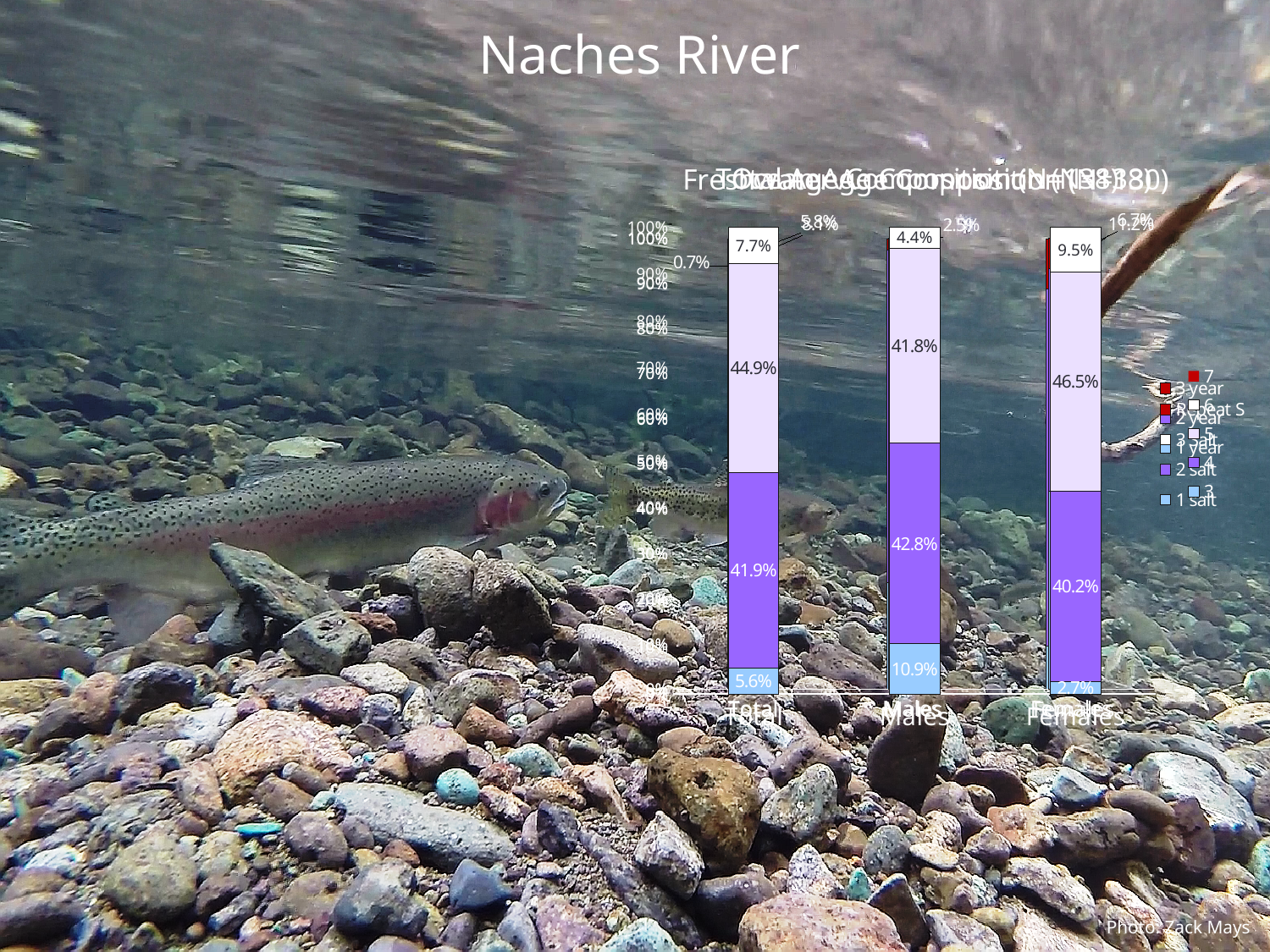
What is the title of the slide? Naches River What is the value of the bottom segment of the Males bar? 10.9% Which bar has the larger bottom segment, Males or Female? Males Which category has the largest bottom segment? Males What is the value of the bottom segment of the Female bar? 2.7% What is the value of the second segment from the bottom of the Female bar? 40.2% What is the value of the large light-coloured segment in the Males bar? 41.8% How many categories are shown along the x axis of the stacked bar chart? 3 What kind of chart is shown on the slide? stacked bar chart What is the value of the second segment from the bottom of the Total bar? 41.9% What is the value of the bottom segment of the Total bar? 5.6% What is the value of the topmost labelled segment of the Female bar? 9.5%